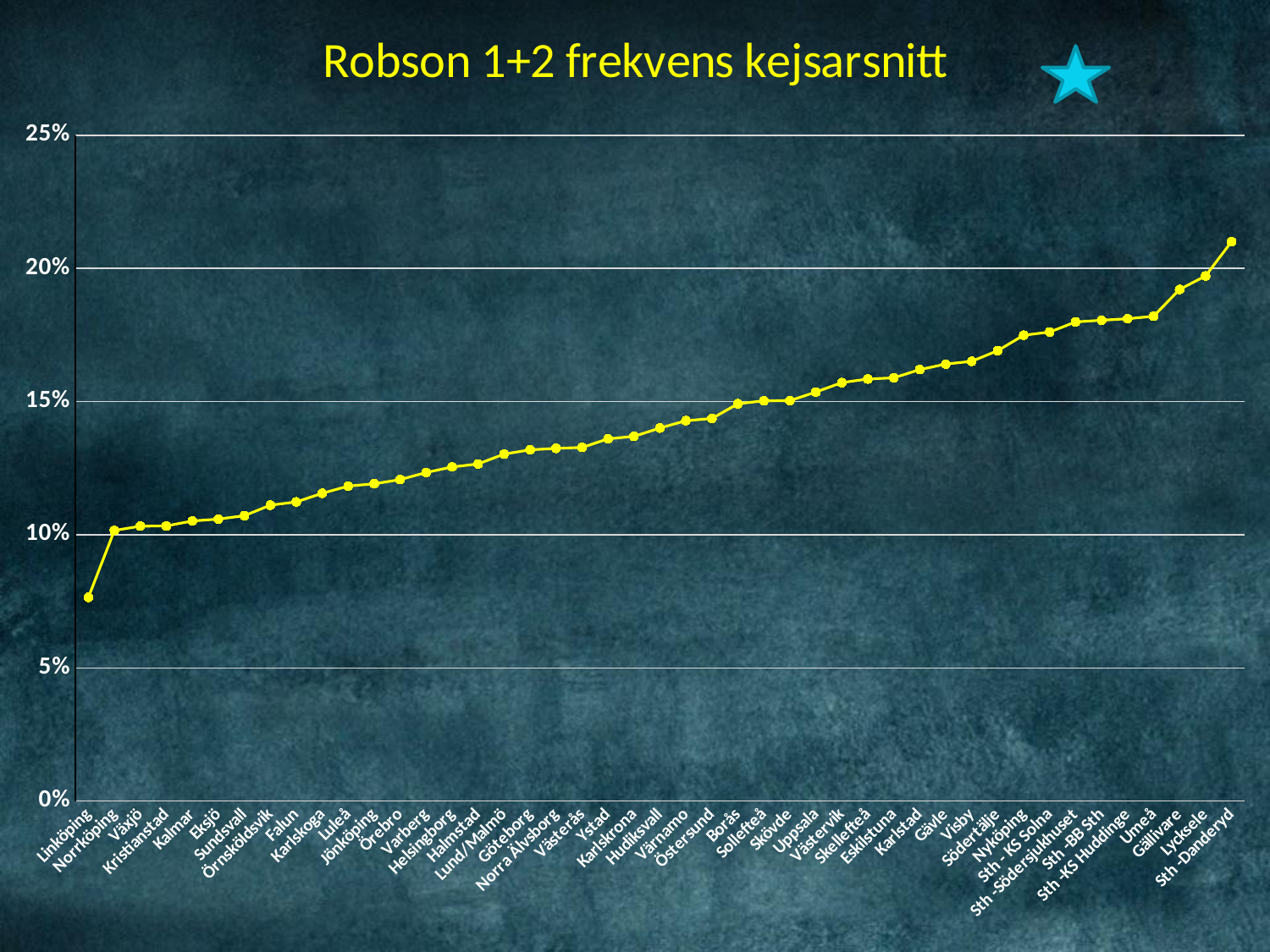
Which category has the highest value? Sth -Danderyd Which has the larger value, Umeå or Falun? Umeå Is the value for Sth -Danderyd greater or less than 20%? greater Is the value for Göteborg greater or less than 15%? less What kind of chart is shown on the slide? line chart How many categories are plotted on the x axis? 45 Is the value for Gällivare greater or less than 20%? less Do the values rise or fall along the x axis from Linköping to Sth -Danderyd? rise What is the title of the chart? Robson 1+2 frekvens kejsarsnitt Which category has the lowest value? Linköping